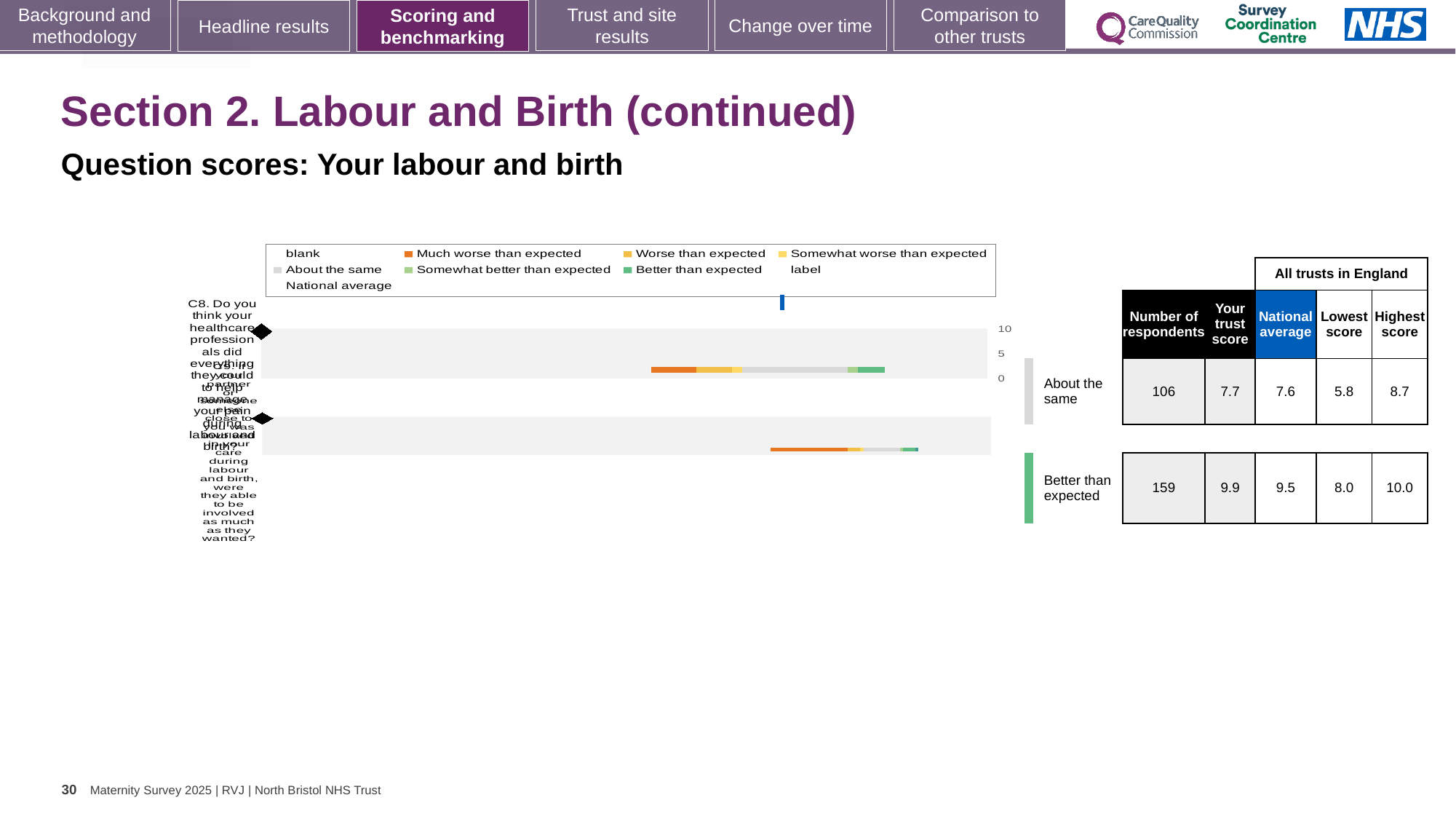
In the table beside the chart, how many respondents are listed for the row rated 'About the same'? 106 In the table beside the chart, what is the highest score for the row rated 'Better than expected'? 10.0 According to the legend, which colour represents 'Much worse than expected'? orange In the table beside the chart, what is the national average for the row rated 'About the same'? 7.6 Which row has more respondents: 'About the same' or 'Better than expected'? Better than expected In the table beside the chart, what is the trust score for the row rated 'Better than expected'? 9.9 What is the highest tick value shown on the chart's axis? 10 How many bars are plotted in the chart? 2 What kind of chart is shown on the slide? bar chart For the row rated 'About the same', what is the difference between the highest score and the lowest score? 2.9 For the row rated 'Better than expected', what is the difference between the trust score and the national average? 0.4 For the row rated 'Better than expected', which is larger: the trust score or the national average? trust score